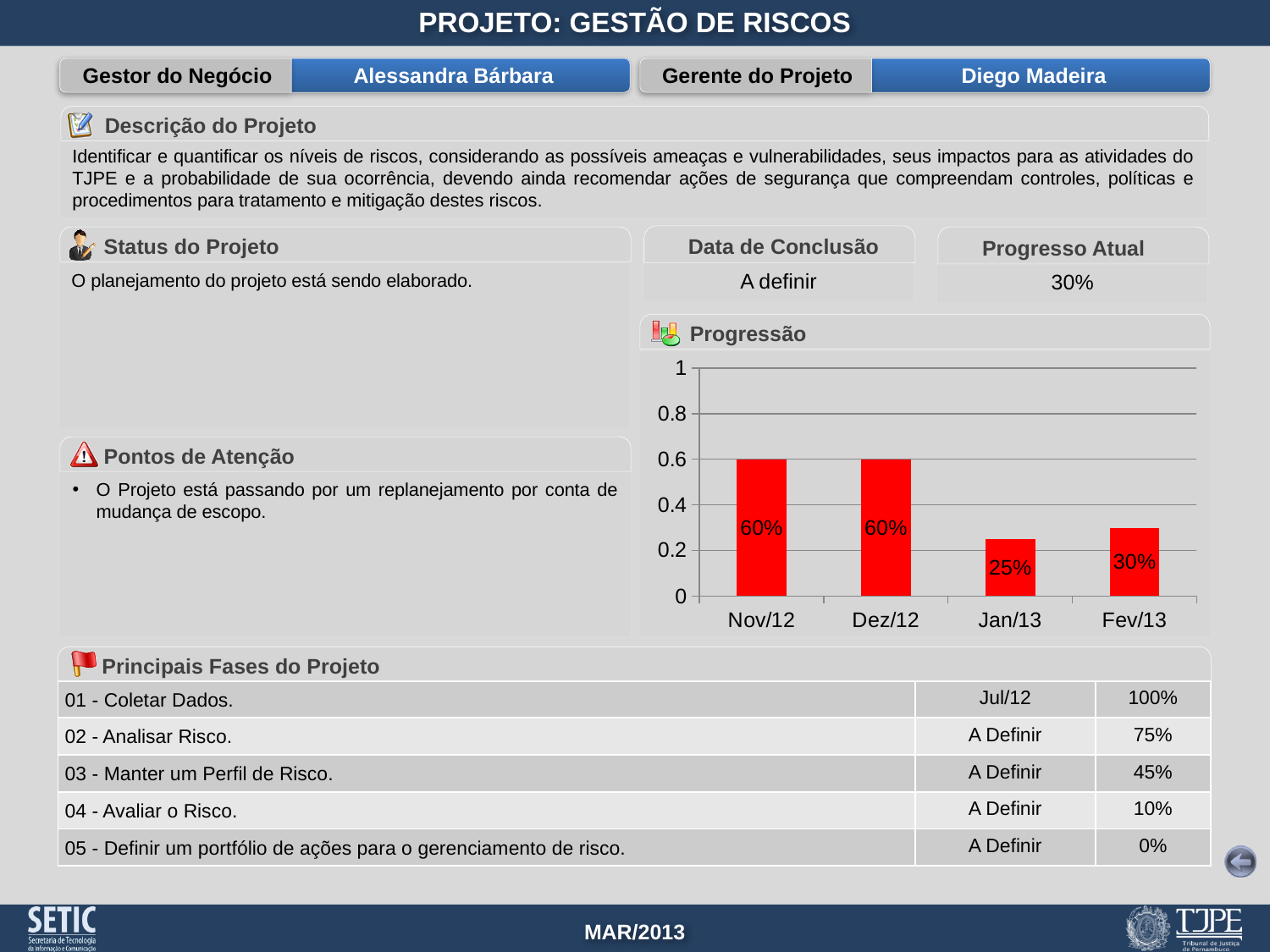
What is the title of the chart on the slide? Progressão What is the value for Fev/13 in the Progressão chart? 30% Which category has the lowest value in the Progressão chart? Jan/13 In the Progressão chart, which is larger: the value for Nov/12 or the value for Fev/13? Nov/12 What is the value for Jan/13 in the Progressão chart? 25% How many categories are shown on the x axis of the Progressão chart? 4 In the Progressão chart, is the value for Jan/13 greater or less than 0.4? less What is the difference between the values for Fev/13 and Jan/13 in the Progressão chart? 5% What is the difference between the values for Dez/12 and Jan/13 in the Progressão chart? 35% What is the value for Nov/12 in the Progressão chart? 60% In the Progressão chart, is the value for Dez/12 greater or less than 0.4? greater What kind of chart is the Progressão chart? bar chart